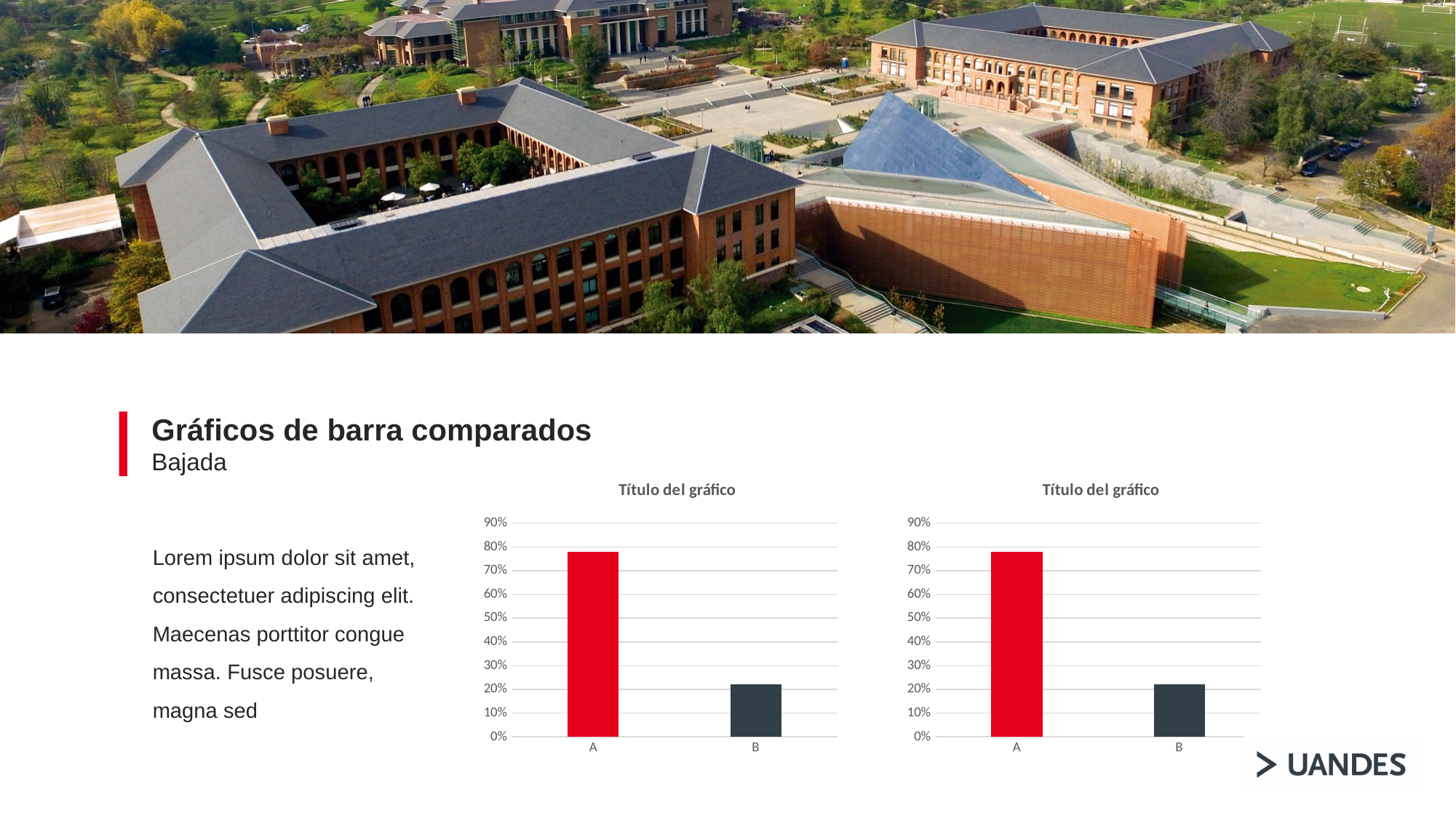
What kind of chart is the left chart on the slide? bar chart What is the title of the right chart? Título del gráfico In the right chart, is the value for A greater or less than 50%? greater In the left chart, which category has the lowest value? B In the left chart, is the value for A greater or less than 70%? greater In the right chart, which category has the highest value? A How many categories are shown on the x axis of the left chart? 2 In the right chart, which category has the lowest value? B In the left chart, is the value for B greater or less than 30%? less In the left chart, which category has the highest value? A What kind of chart is the right chart on the slide? bar chart